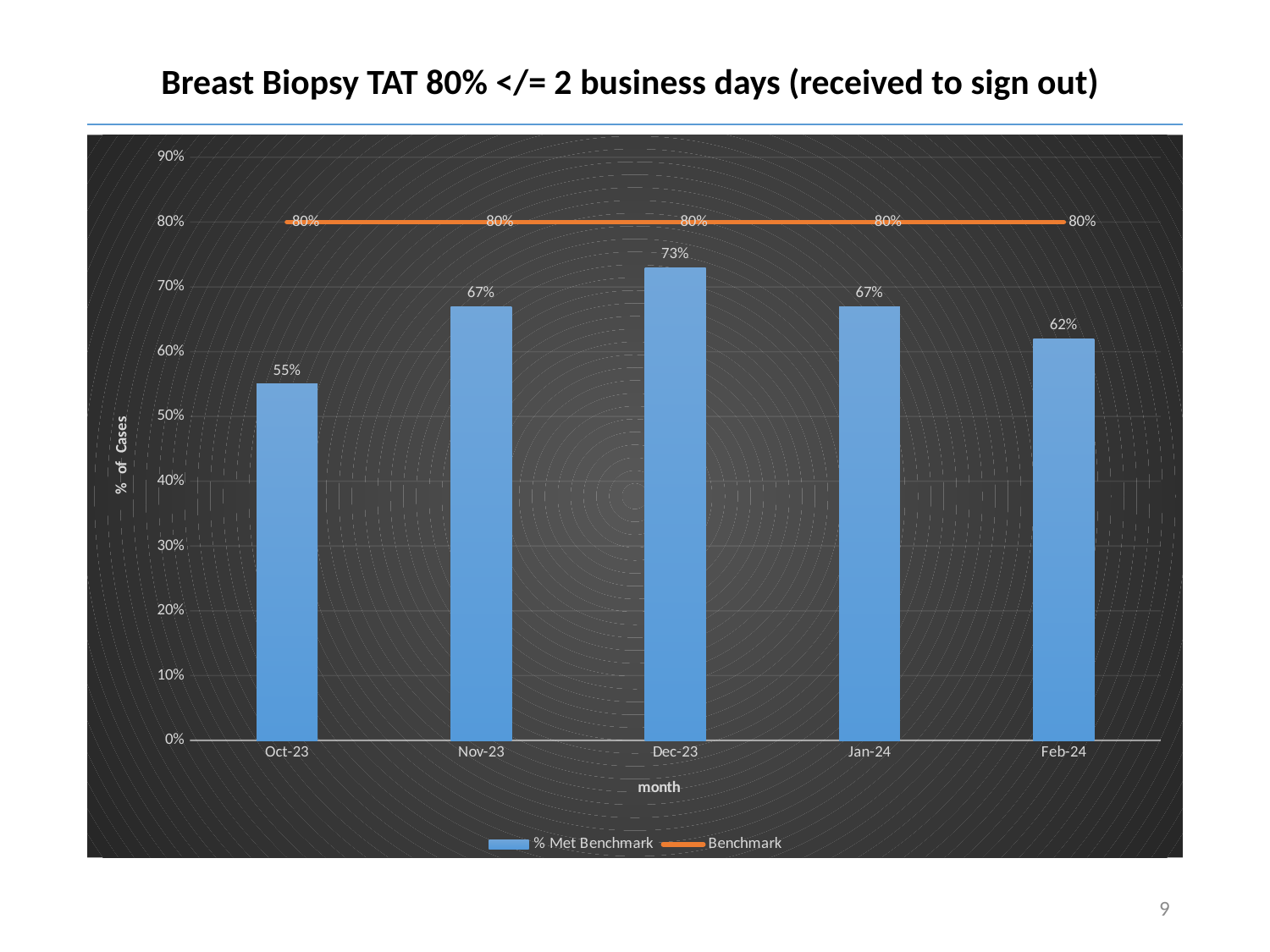
How many months are shown on the x axis? 5 What is the difference between the Benchmark and the % Met Benchmark value for Feb-24? 18% What is the % Met Benchmark value for Oct-23? 55% How many series does the legend list? 2 What is the % Met Benchmark value for Feb-24? 62% Which month has the lowest % Met Benchmark value? Oct-23 What kind of chart is used to show the % Met Benchmark series? Bar chart Which month has the highest % Met Benchmark value? Dec-23 What is the Benchmark value shown for Jan-24? 80% Which is larger, the % Met Benchmark value for Nov-23 or for Feb-24? Nov-23 What is the difference between the % Met Benchmark values for Dec-23 and Oct-23? 18% What is the % Met Benchmark value for Dec-23? 73%